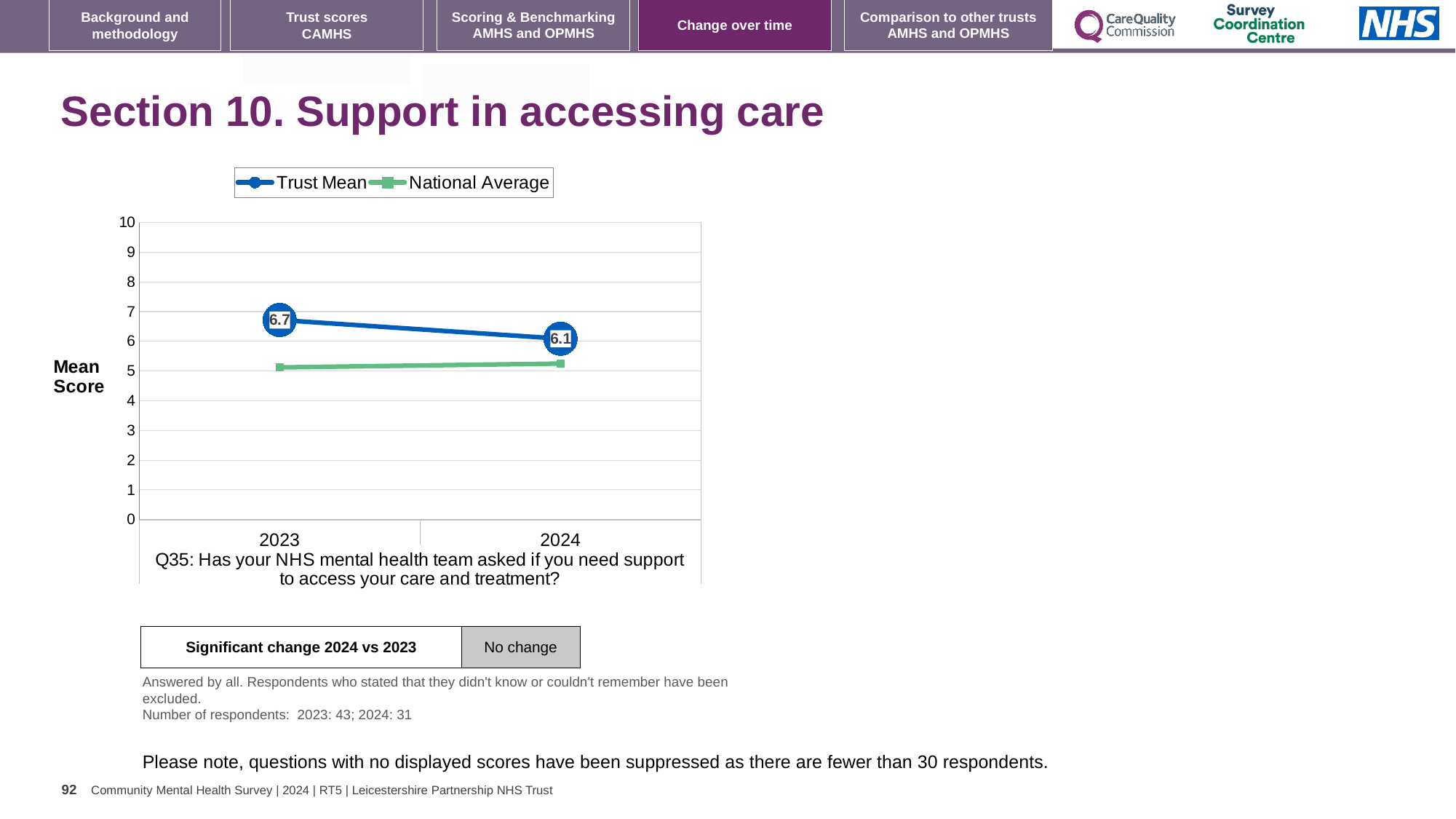
How many years are plotted on the x axis? 2 What is the Trust Mean value for 2024? 6.1 In 2024, which is larger: the Trust Mean or the National Average? Trust Mean Is the National Average value for 2023 greater or less than 6? less What kind of chart is shown on the slide? line chart Is the National Average value for 2024 greater or less than 6? less By how much did the Trust Mean change between 2023 and 2024? 0.6 What is the label on the y axis of the chart? Mean Score In which year is the Trust Mean highest? 2023 What is the Trust Mean value for 2023? 6.7 Does the Trust Mean rise or fall from 2023 to 2024? fall How many series does the legend list? 2